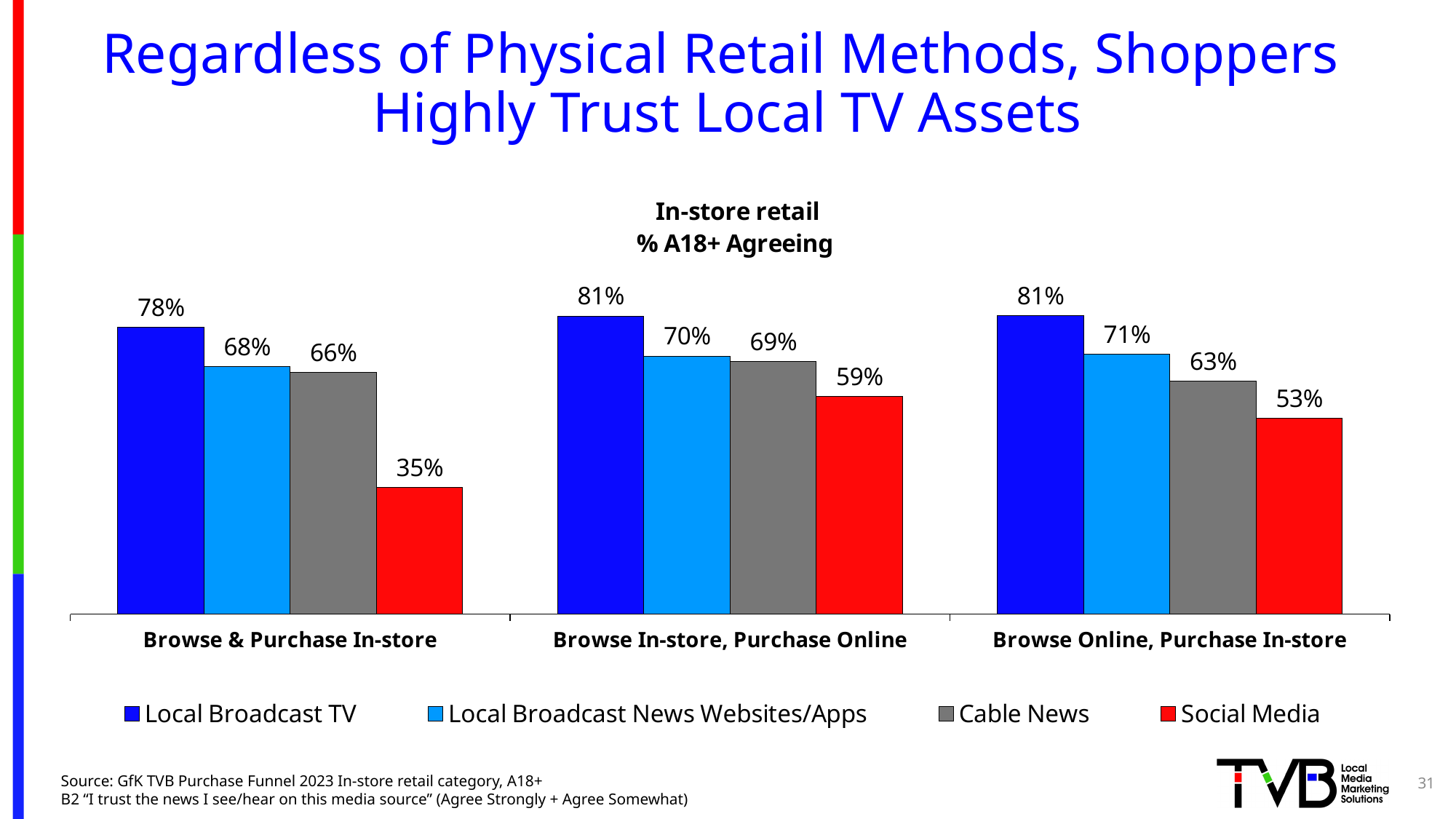
What is the value for Social Media in the Browse In-store, Purchase Online category? 59% How many series does the legend list? 4 What colour represents Cable News in the chart? Grey How many categories are shown on the x axis? 3 Which series has the highest value in the Browse In-store, Purchase Online category? Local Broadcast TV What is the value for Cable News in the Browse Online, Purchase In-store category? 63% What is the difference between Local Broadcast TV and Social Media in the Browse & Purchase In-store category? 43 percentage points Which series has the lowest value in the Browse & Purchase In-store category? Social Media What is the difference between Local Broadcast News Websites/Apps and Cable News in the Browse Online, Purchase In-store category? 8 percentage points Which is larger: Social Media in Browse In-store, Purchase Online or Social Media in Browse Online, Purchase In-store? Browse In-store, Purchase Online What is the value for Local Broadcast TV in the Browse & Purchase In-store category? 78% What kind of chart is shown on the slide? Bar chart